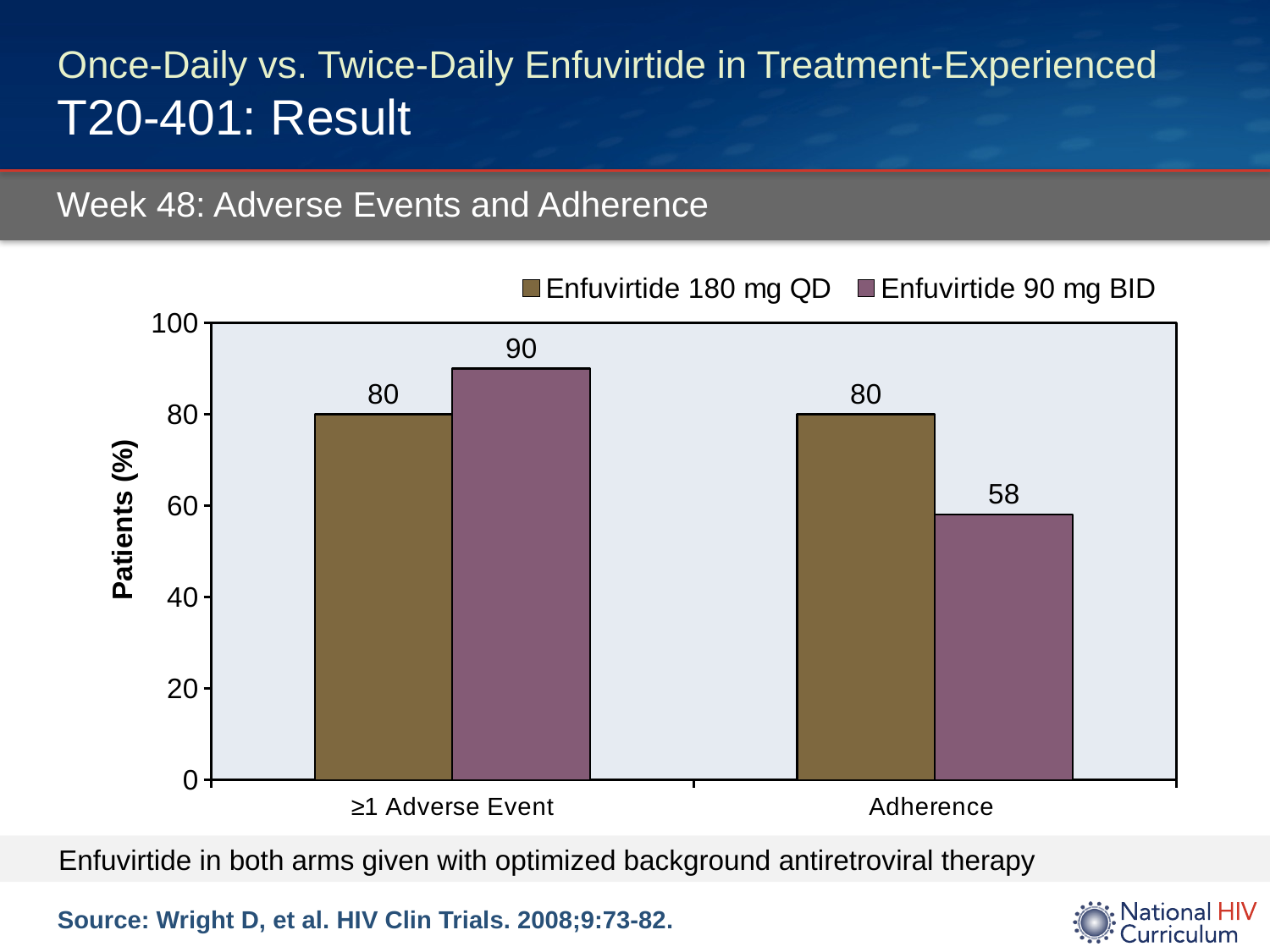
What kind of chart is shown on the slide? Bar chart What is the difference in the ≥1 Adverse Event rate between the Enfuvirtide 90 mg BID and Enfuvirtide 180 mg QD arms? 10 How many categories are shown on the x axis? 2 How many series does the legend list? 2 Which arm has the higher value for ≥1 Adverse Event? Enfuvirtide 90 mg BID What is the difference in Adherence between the Enfuvirtide 180 mg QD and Enfuvirtide 90 mg BID arms? 22 What is the Adherence value for the Enfuvirtide 90 mg BID arm? 58 Which bar in the chart has the lowest value? Enfuvirtide 90 mg BID, Adherence What percentage of patients in the Enfuvirtide 90 mg BID arm had ≥1 Adverse Event? 90 What is the Adherence value for the Enfuvirtide 180 mg QD arm? 80 Which arm has the higher Adherence value? Enfuvirtide 180 mg QD What percentage of patients in the Enfuvirtide 180 mg QD arm had ≥1 Adverse Event? 80